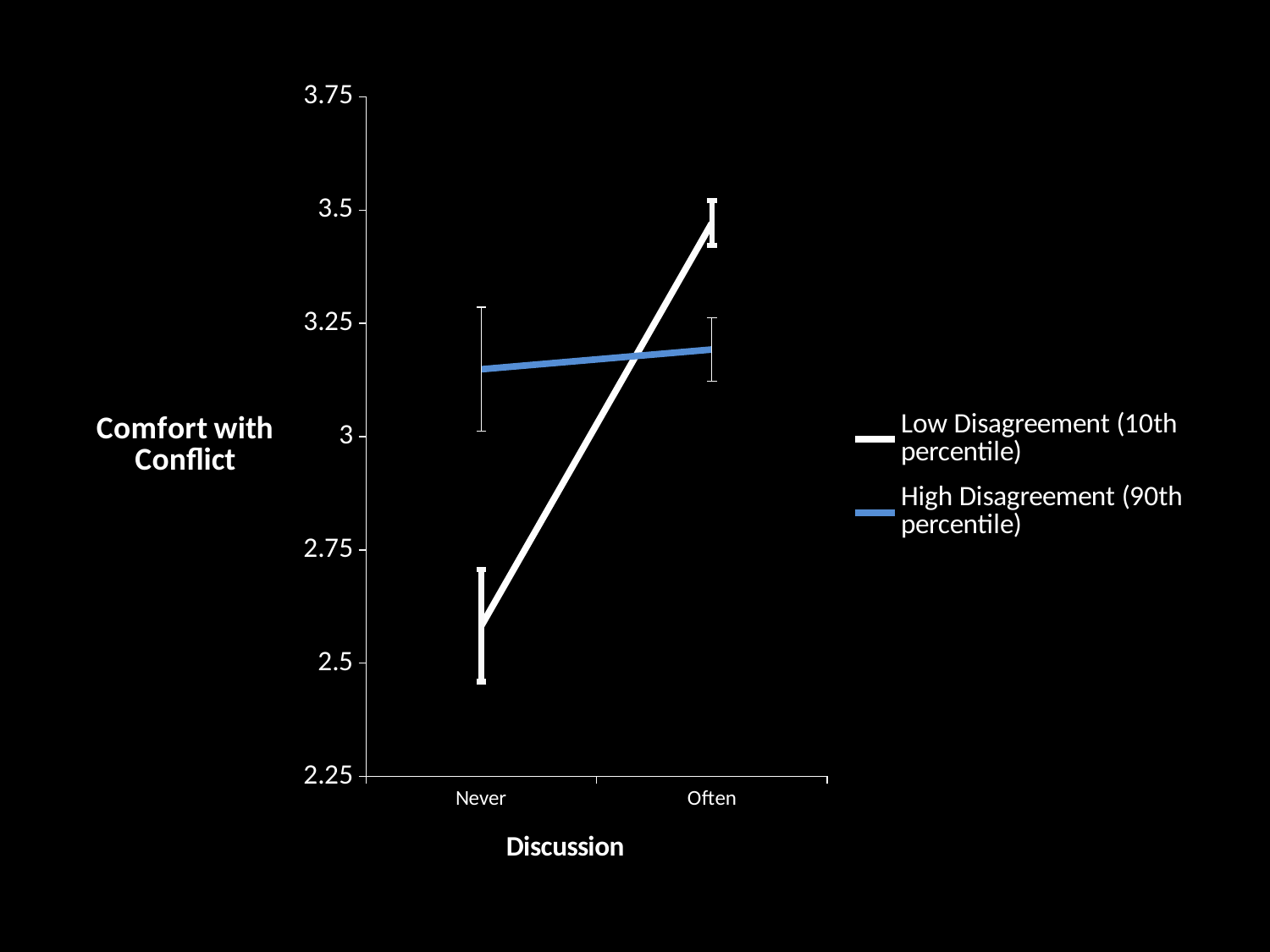
At Often, which series has the higher value: Low Disagreement (10th percentile) or High Disagreement (90th percentile)? Low Disagreement (10th percentile) Is the value for Low Disagreement (10th percentile) at Often greater or less than 3.25? greater Is the value for High Disagreement (90th percentile) at Often greater or less than 3.25? less What is the title of the y axis? Comfort with Conflict How many series does the legend list? 2 What colour is the line for High Disagreement (90th percentile)? blue At Never, which series has the higher value: Low Disagreement (10th percentile) or High Disagreement (90th percentile)? High Disagreement (90th percentile) How many categories are shown on the x axis? 2 What kind of chart is shown on the slide? line chart Does the Low Disagreement (10th percentile) line rise or fall from Never to Often? rise Is the value for High Disagreement (90th percentile) at Never greater or less than 3? greater